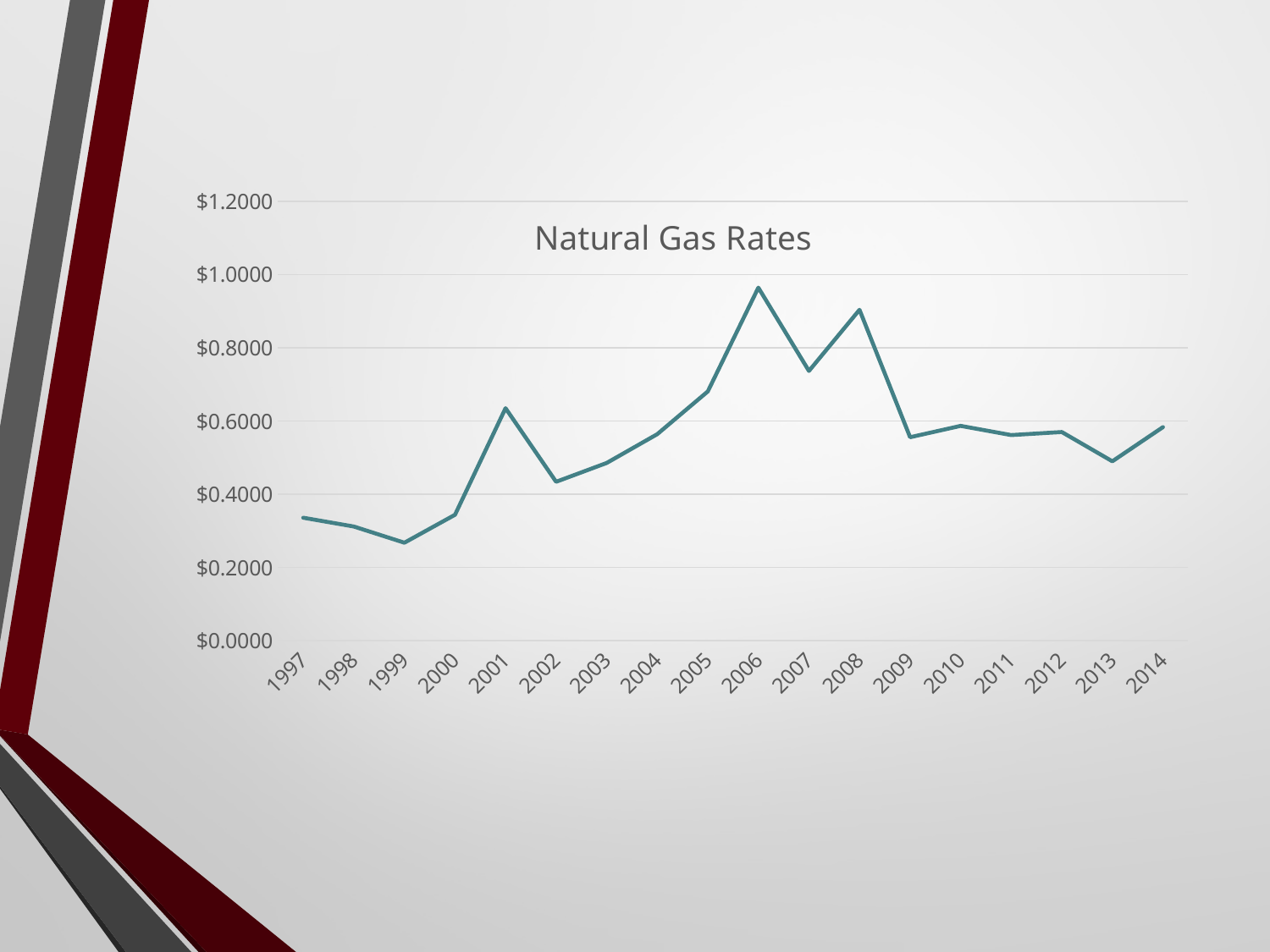
Is the value for 2001 greater or less than $0.6000? greater Which year has the larger value, 2006 or 2008? 2006 Which year has the highest natural gas rate? 2006 Which year has the larger value, 2002 or 2005? 2005 What is the title of the chart? Natural Gas Rates Is the value for 1999 greater or less than $0.4000? less How many years are plotted along the x axis? 18 Is the value for 2006 greater or less than $0.8000? greater What kind of chart is shown on the slide? line chart Do the values rise or fall from 2002 to 2006? rise Which year has the lowest natural gas rate? 1999